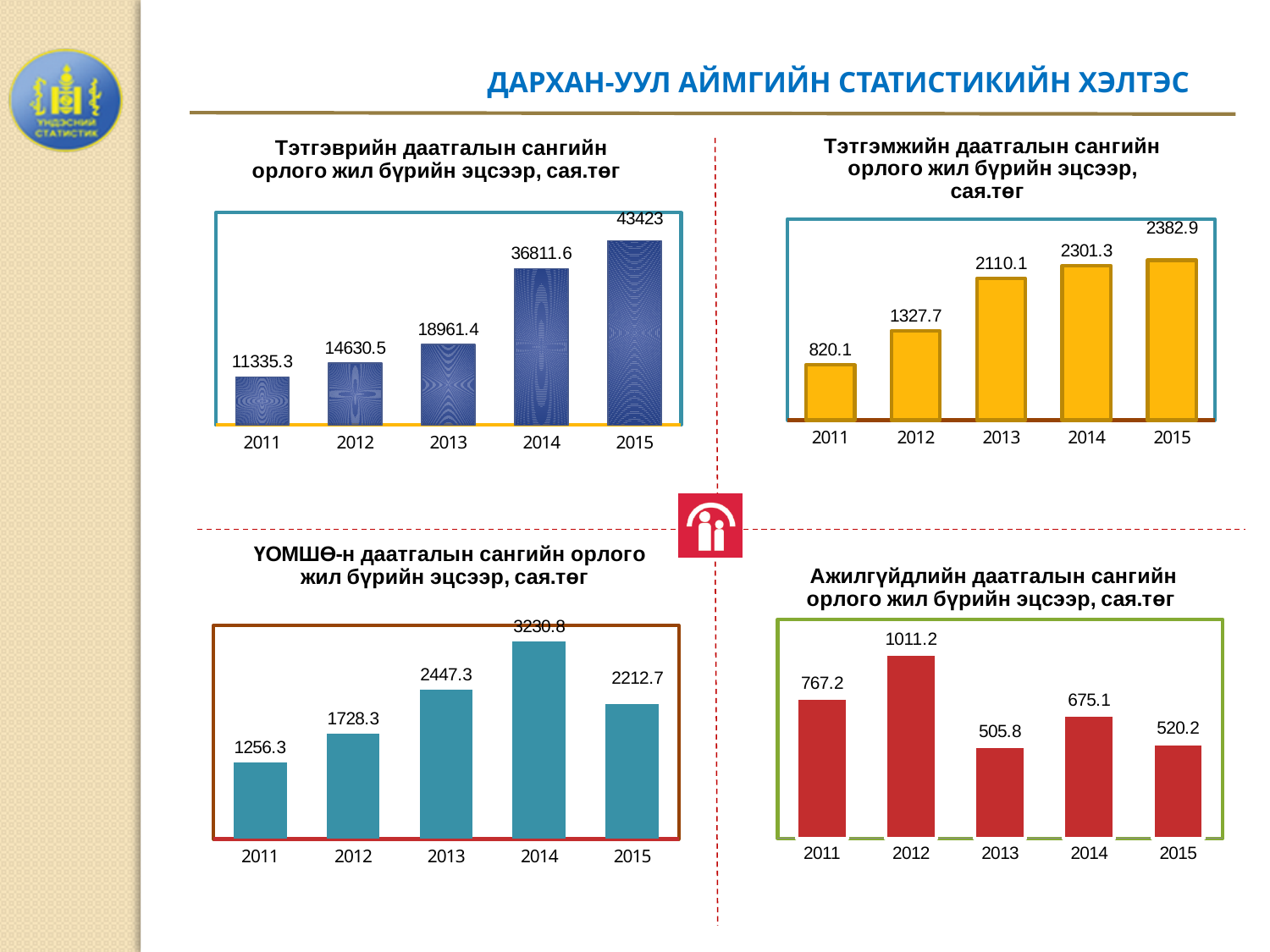
In the top-right chart (Тэтгэмжийн даатгалын сангийн орлого), what is the value for 2014? 2301.3 In the top-right chart (Тэтгэмжийн даатгалын сангийн орлого), do the values rise or fall from 2011 to 2015? Rise In the top-left chart (Тэтгэврийн даатгалын сангийн орлого), what is the value for 2015? 43423 In the bottom-right chart (Ажилгүйдлийн даатгалын сангийн орлого), what is the value for 2011? 767.2 In the bottom-right chart (Ажилгүйдлийн даатгалын сангийн орлого), which is larger, the value for 2013 or the value for 2014? 2014 How many years are shown on the x axis of the top-left chart (Тэтгэврийн даатгалын сангийн орлого)? 5 In the bottom-right chart (Ажилгүйдлийн даатгалын сангийн орлого), which year has the highest value? 2012 In the bottom-left chart (ҮОМШӨ-н даатгалын сангийн орлого), what is the difference between the 2014 and 2015 values? 1018.1 In the top-right chart (Тэтгэмжийн даатгалын сангийн орлого), which year has the lowest value? 2011 What kind of chart is the top-right chart (Тэтгэмжийн даатгалын сангийн орлого)? Bar chart In the top-left chart (Тэтгэврийн даатгалын сангийн орлого), what is the value for 2013? 18961.4 In the bottom-left chart (ҮОМШӨ-н даатгалын сангийн орлого), which year has the highest value? 2014